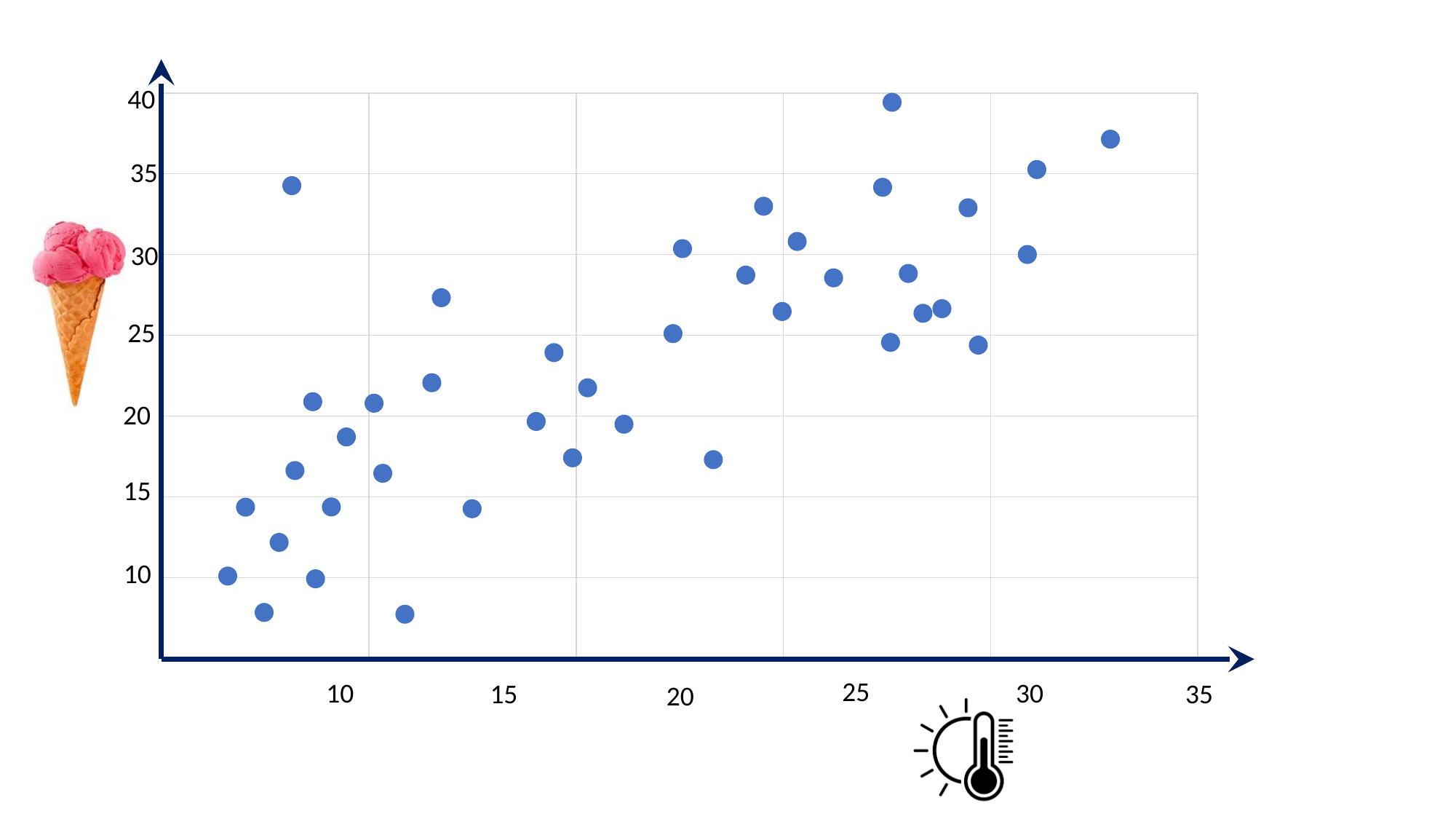
Do the plotted y values generally rise or fall as the x value increases? rise Is the y value of the highest point on the chart greater or less than 35? greater Is the y value of the lowest point on the chart greater or less than 10? less Is the y value of the leftmost point on the chart greater or less than 15? less What is the highest tick label shown on the y axis? 40 What kind of chart is shown on the slide? scatter plot What is the highest tick label shown on the x axis? 35 Which point has the larger y value: the rightmost point or the leftmost point? the rightmost point